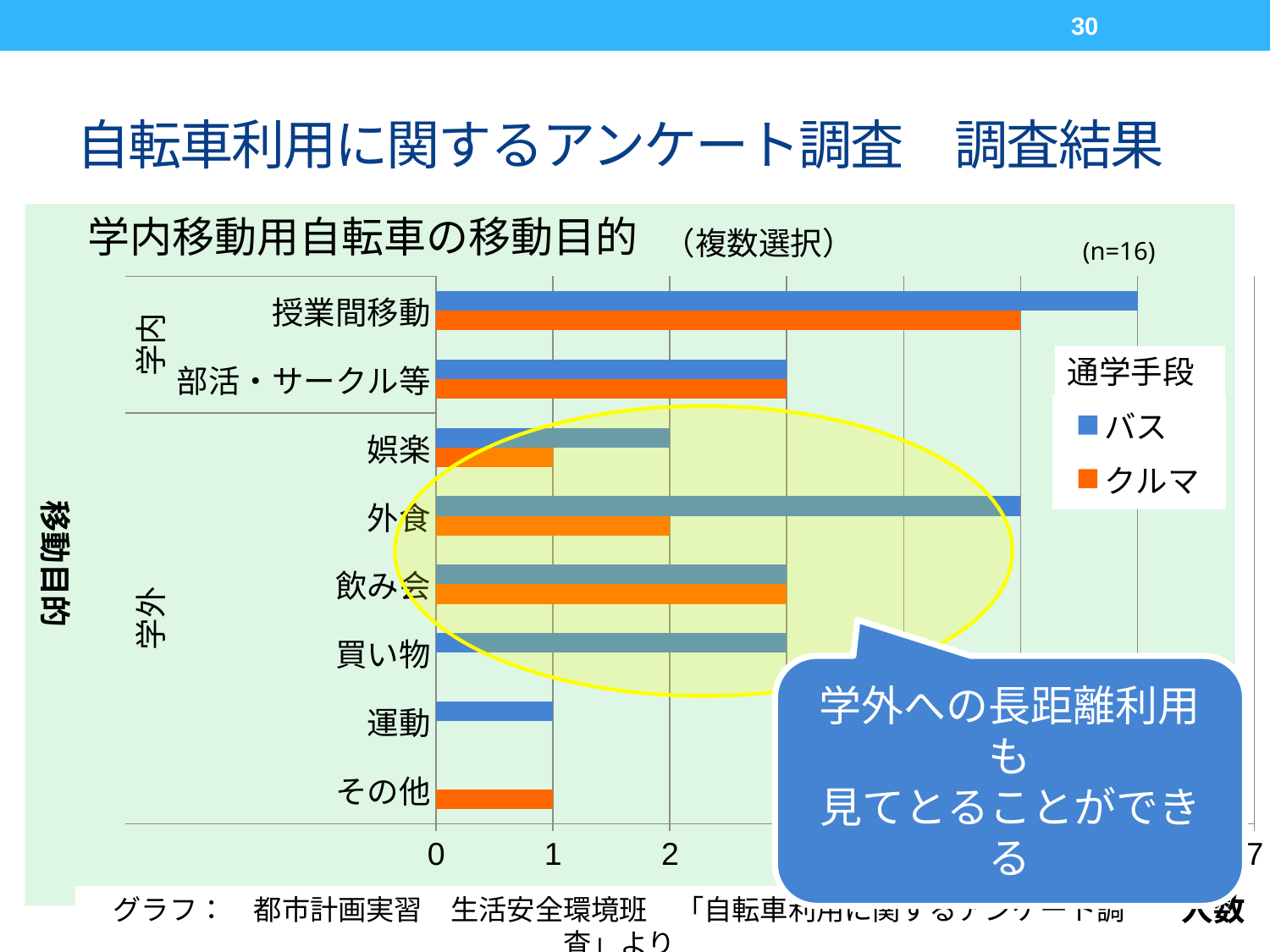
Is the value for バス in the 授業間移動 category greater or less than 2? greater How many series does the legend list? 2 In the 外食 category, which is larger, バス or クルマ? バス What kind of chart is shown on the slide? bar chart What is the value for バス in the 娯楽 category? 2 What is the value for バス in the 運動 category? 1 Which category has the highest value for バス? 授業間移動 What is the sample size (n) shown on the chart? n=16 What is the value for クルマ in the 娯楽 category? 1 What is the value for クルマ in the その他 category? 1 What is the value for クルマ in the 外食 category? 2 How many categories (移動目的) are plotted on the y axis? 8